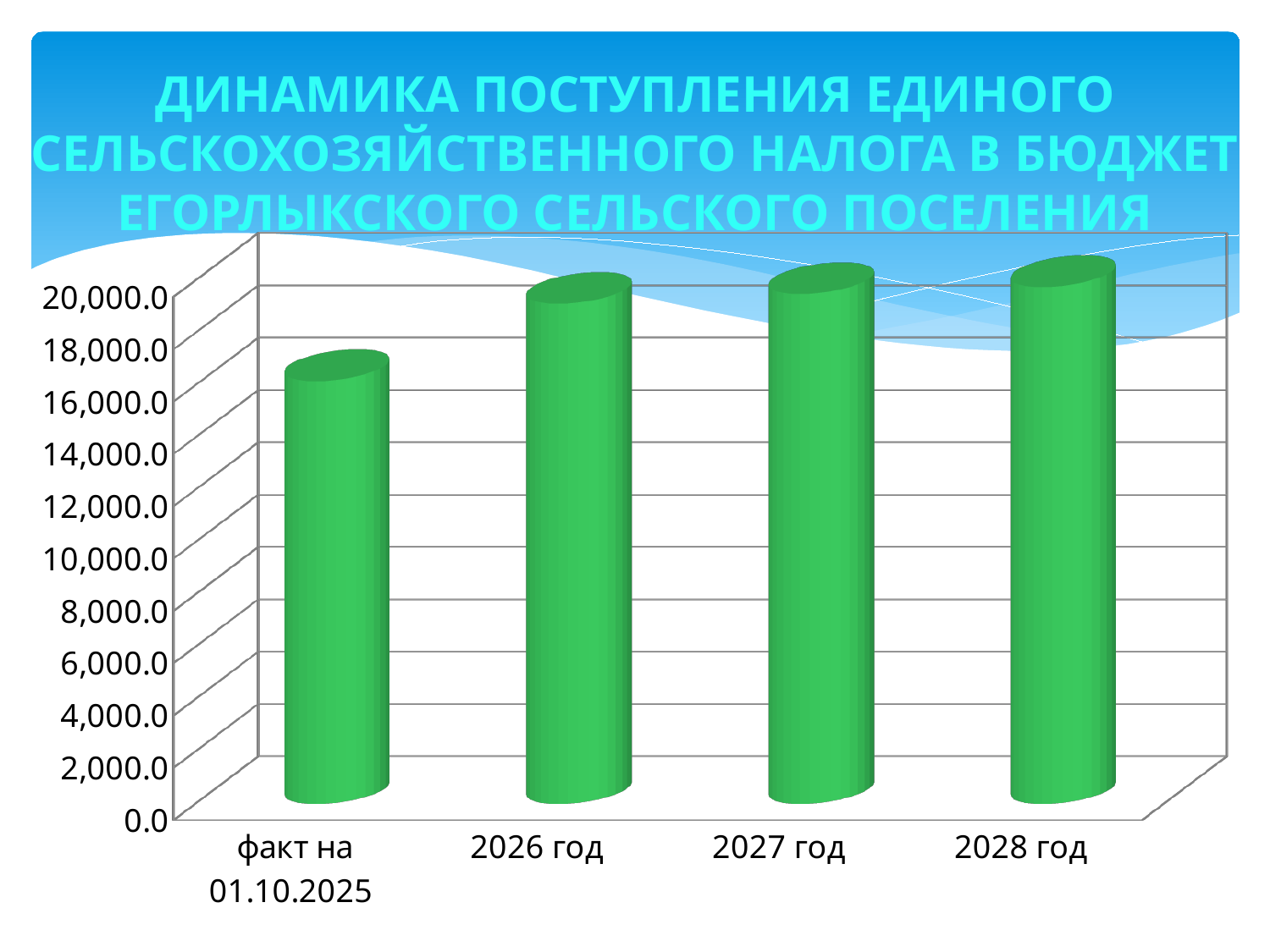
Is the value for 2027 год greater or less than 16,000.0? greater How many categories are shown on the x axis of the chart? 4 Which category has the lowest value in the chart? факт на 01.10.2025 Do the values generally rise or fall from left to right along the x axis? rise Is the value for 2026 год greater or less than 18,000.0? greater Which is larger, the value for факт на 01.10.2025 or the value for 2026 год? 2026 год Is the value for факт на 01.10.2025 greater or less than 14,000.0? greater What kind of chart is shown on the slide? bar chart What is the title of the chart on the slide? ДИНАМИКА ПОСТУПЛЕНИЯ ЕДИНОГО СЕЛЬСКОХОЗЯЙСТВЕННОГО НАЛОГА В БЮДЖЕТ ЕГОРЛЫКСКОГО СЕЛЬСКОГО ПОСЕЛЕНИЯ Which is larger, the value for факт на 01.10.2025 or the value for 2028 год? 2028 год